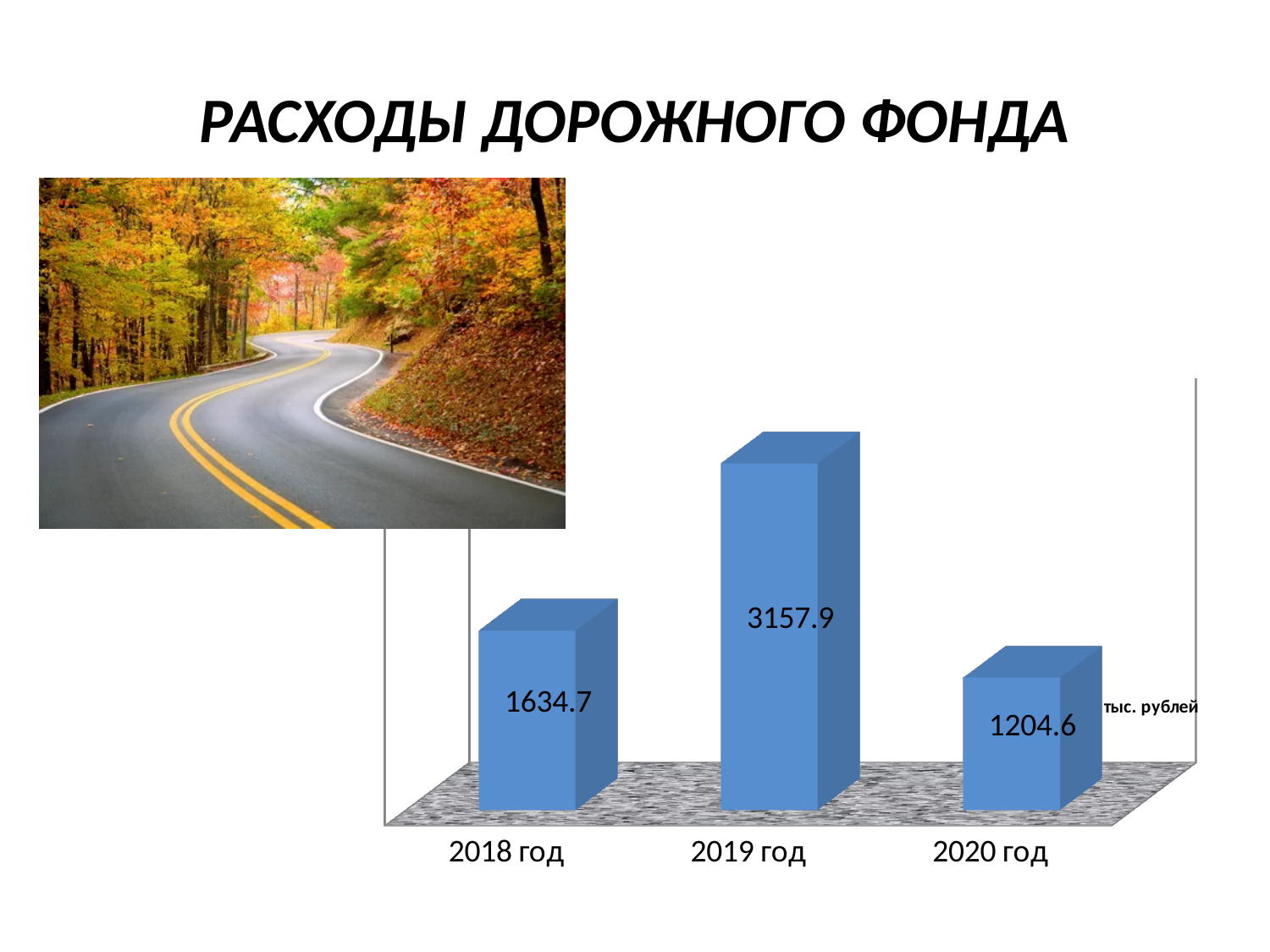
What is the value for 2020 год? 1204.6 Which is larger, the value for 2018 год or the value for 2020 год? 2018 год Which year has the highest value? 2019 год What is the difference between the values for 2019 год and 2018 год? 1523.2 What is the difference between the values for 2018 год and 2020 год? 430.1 What unit is indicated next to the chart? тыс. рублей What is the title of the slide containing the chart? РАСХОДЫ ДОРОЖНОГО ФОНДА How many categories are shown on the chart? 3 Which year has the lowest value? 2020 год What is the value for 2018 год? 1634.7 What is the value for 2019 год? 3157.9 What kind of chart is shown on the slide? bar chart